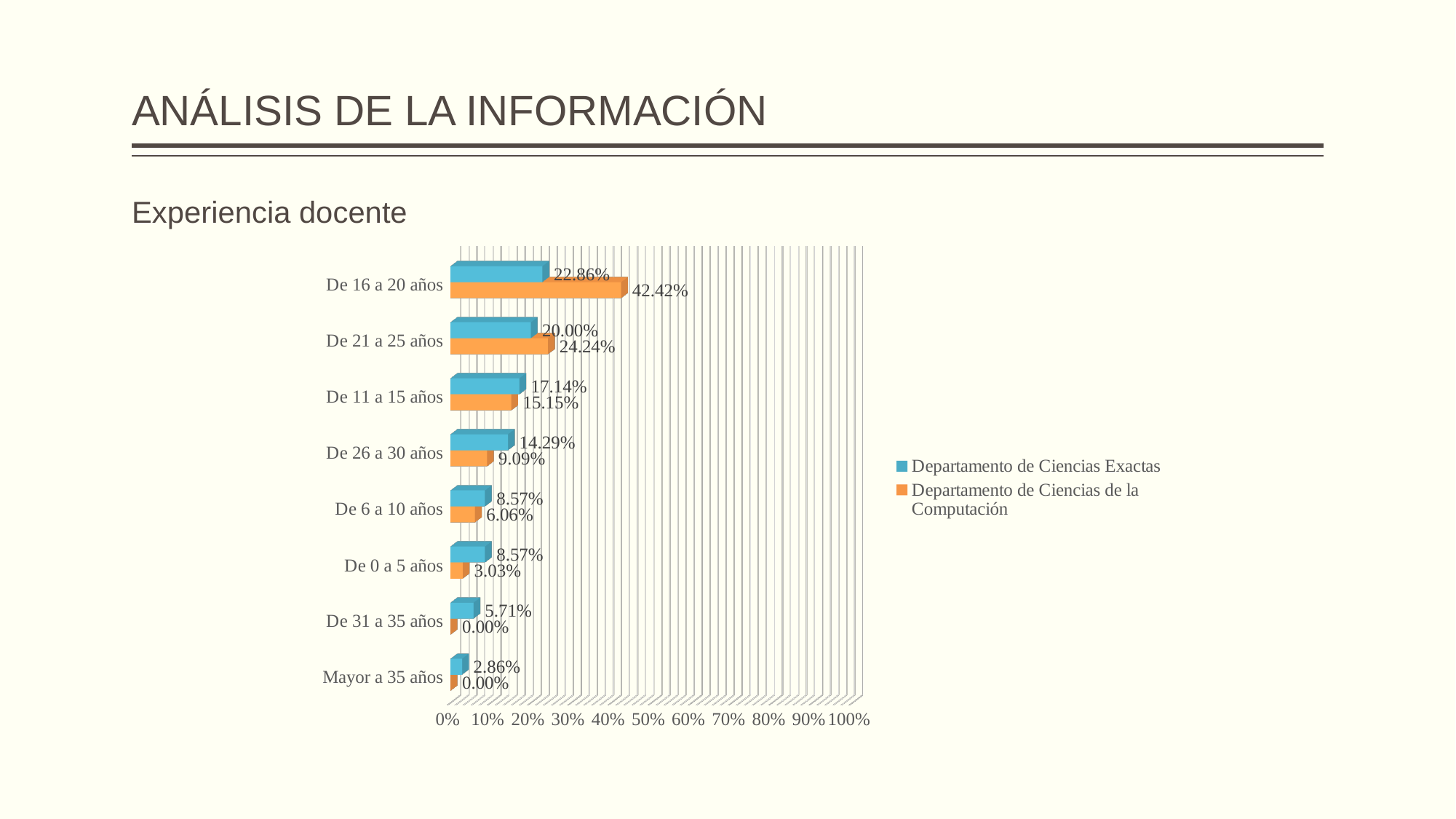
What is the value for Departamento de Ciencias de la Computación in the 'De 16 a 20 años' category? 42.42% Which category has the lowest value for Departamento de Ciencias Exactas? Mayor a 35 años Is the value for Departamento de Ciencias de la Computación in 'De 16 a 20 años' greater or less than 40%? greater How many experience categories are shown on the chart? 8 What is the value for Departamento de Ciencias de la Computación in the 'De 26 a 30 años' category? 9.09% What is the value for Departamento de Ciencias Exactas in the 'De 21 a 25 años' category? 20.00% In the 'De 11 a 15 años' category, which series has the larger value? Departamento de Ciencias Exactas Which colour represents Departamento de Ciencias de la Computación in the chart? Orange What is the difference between the Departamento de Ciencias de la Computación value and the Departamento de Ciencias Exactas value in the 'De 16 a 20 años' category? 19.56% How many series does the legend list? 2 What kind of chart is shown on the slide? Bar chart Which category has the highest value for Departamento de Ciencias Exactas? De 16 a 20 años